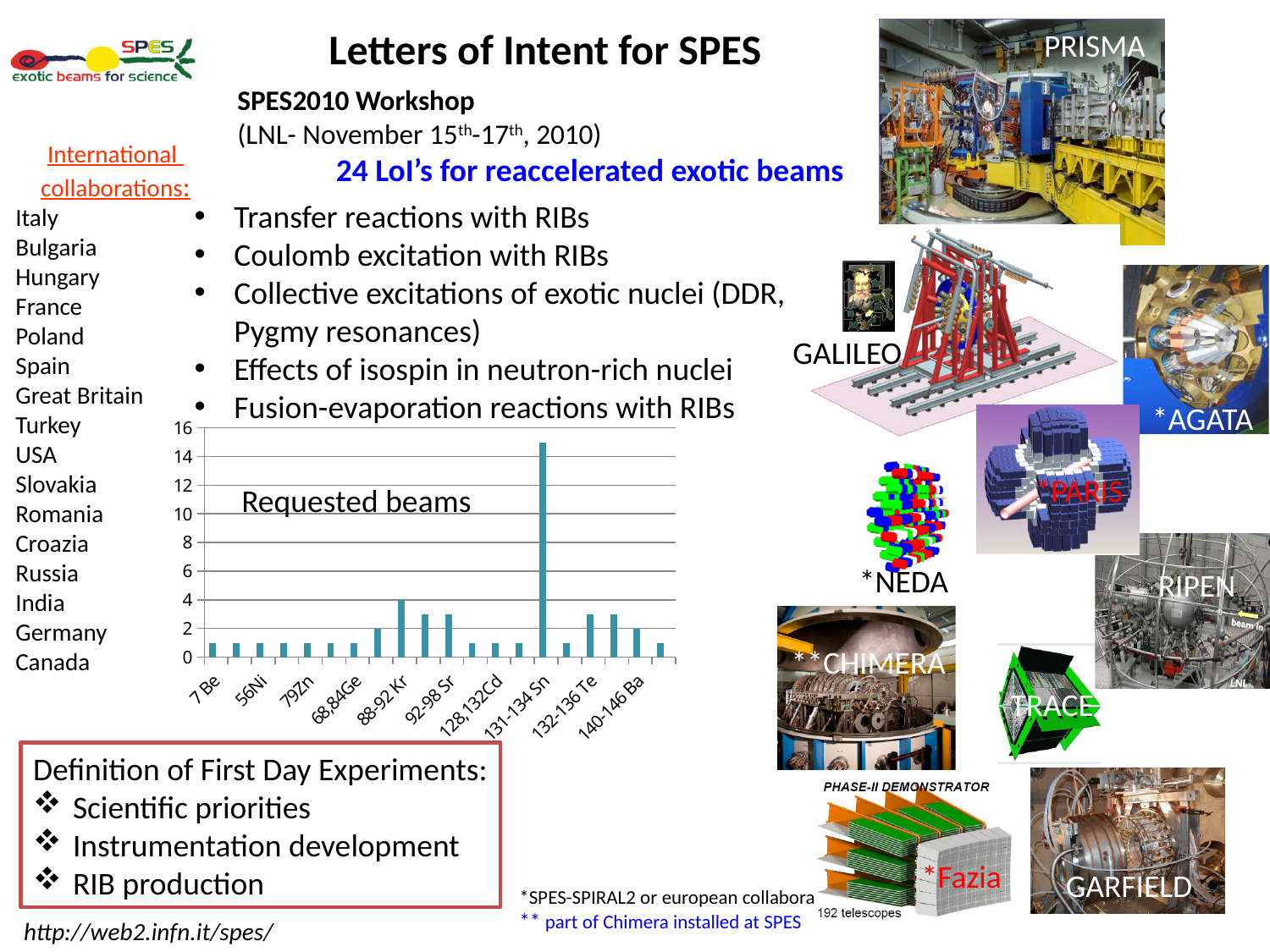
In the 'Requested beams' chart, which beam has the highest number of requests? 131-134 Sn What is the maximum value shown on the y-axis of the 'Requested beams' chart? 16 In the 'Requested beams' chart, which has more requests, 88-92 Kr or 92-98 Sr? 88-92 Kr In the 'Requested beams' chart, is the value for 7Be greater or less than 2? less What kind of chart is the 'Requested beams' chart? bar chart In the 'Requested beams' chart, is the value for 132-136 Te greater or less than 2? greater In the 'Requested beams' chart, what is the value for 140-146 Ba? 2 What is the title shown on the bar chart? Requested beams In the 'Requested beams' chart, what is the value for 88-92 Kr? 4 In the 'Requested beams' chart, is the value for 131-134 Sn greater or less than 14? greater In the 'Requested beams' chart, which has more requests, 131-134 Sn or 88-92 Kr? 131-134 Sn